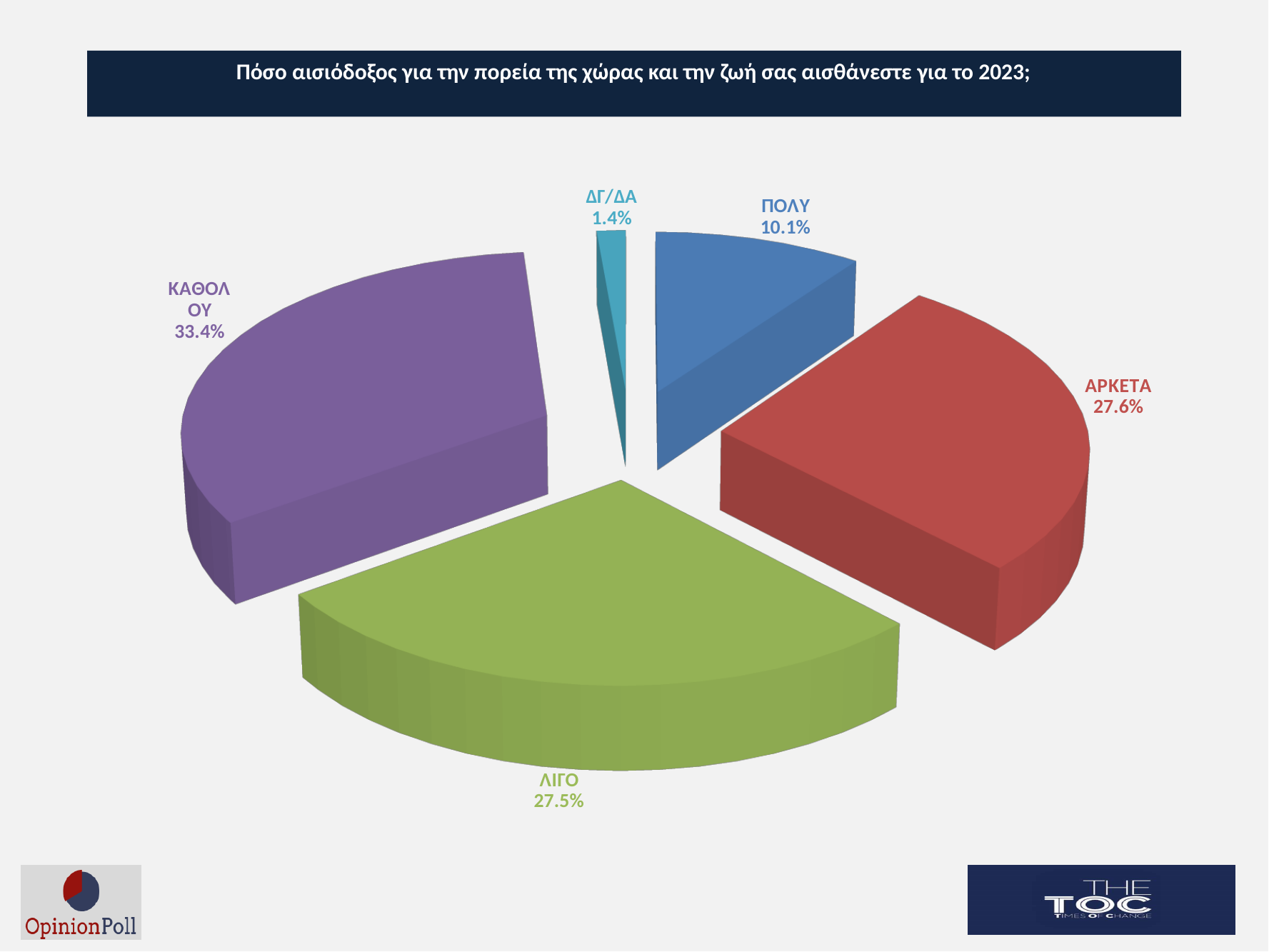
What percentage of respondents answered ΛΙΓΟ? 27.5% What is the difference in percentage points between ΚΑΘΟΛΟΥ and ΑΡΚΕΤΑ? 5.8% Which is larger, the share for ΠΟΛΥ or the share for ΑΡΚΕΤΑ? ΑΡΚΕΤΑ How many response categories are shown in the pie chart? 5 Which response has the smallest share of the pie? ΔΓ/ΔΑ Which response has the largest share of the pie? ΚΑΘΟΛΟΥ What colour is the ΛΙΓΟ slice? Green What percentage of respondents answered ΚΑΘΟΛΟΥ? 33.4% What kind of chart is shown on the slide? Pie chart What percentage of respondents answered ΔΓ/ΔΑ? 1.4% What percentage of respondents answered ΠΟΛΥ? 10.1% What is the difference in percentage points between ΑΡΚΕΤΑ and ΛΙΓΟ? 0.1%